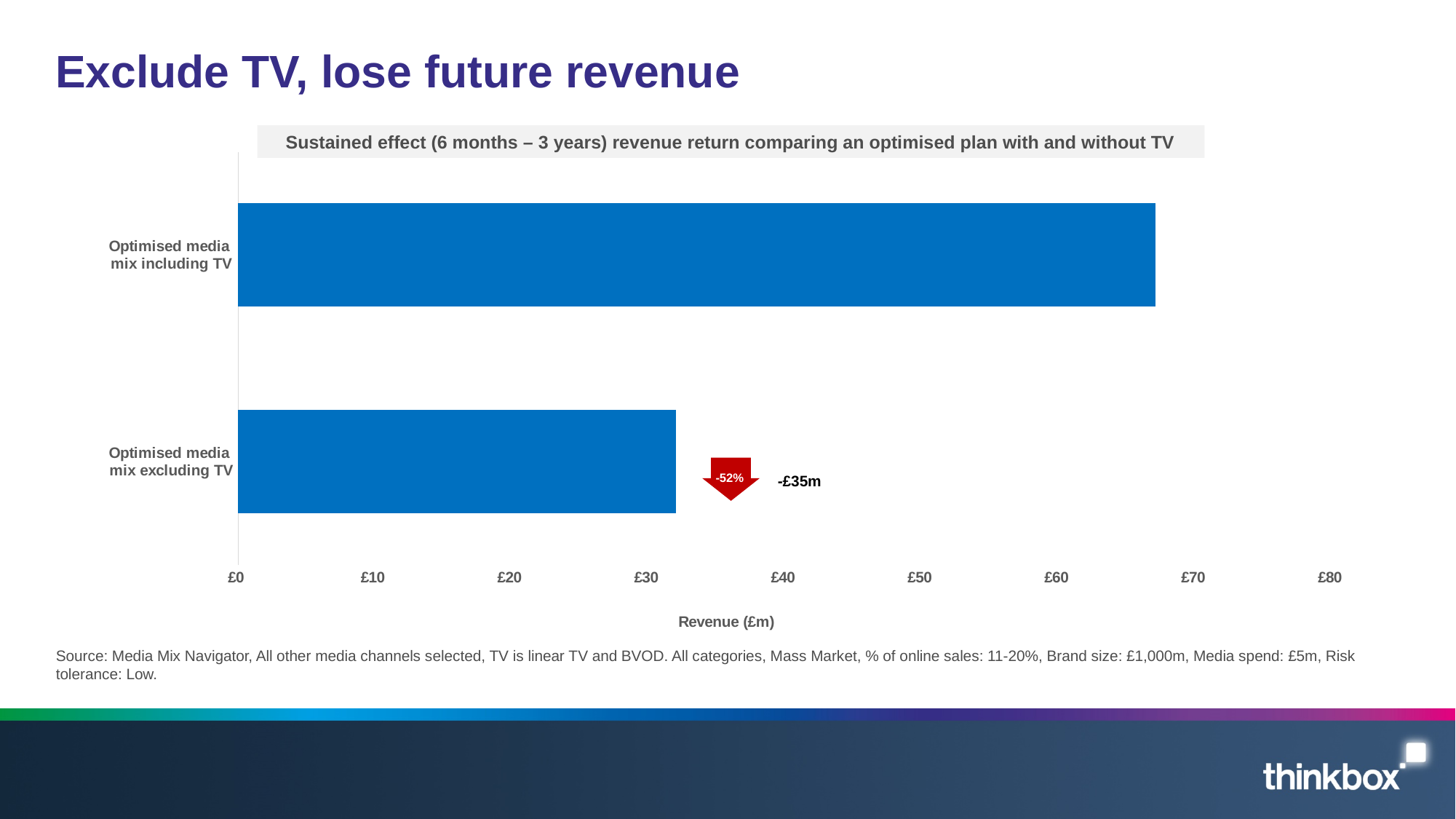
What is the label of the horizontal axis? Revenue (£m) Which media mix has the higher revenue return? Optimised media mix including TV Is the revenue for the optimised media mix including TV greater or less than £70? less What revenue loss in £m is annotated next to the 'excluding TV' bar? -£35m What percentage change is shown in the red arrow on the chart? -52% Which media mix has the lower revenue return? Optimised media mix excluding TV How many categories (bars) does the chart show? 2 Is the revenue for the optimised media mix including TV greater or less than £60? greater Is the revenue for the optimised media mix excluding TV greater or less than £40? less Which is larger: the revenue for the media mix including TV or the media mix excluding TV? Optimised media mix including TV What is the highest value shown on the horizontal axis? £80 What kind of chart is shown on the slide? bar chart